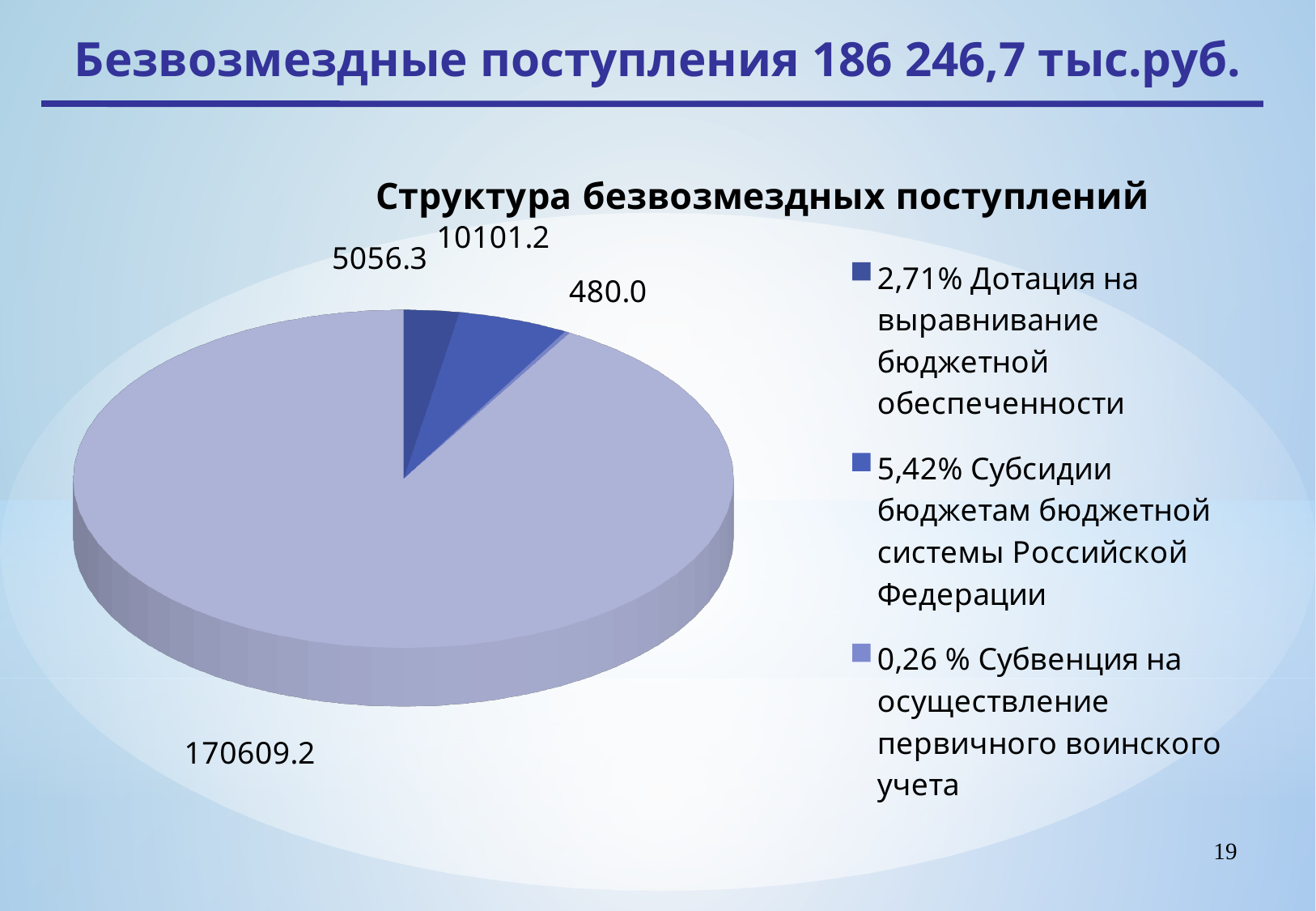
What is the chart's title? Структура безвозмездных поступлений What value is shown for Субвенция на осуществление первичного воинского учета? 480.0 How many slices does the pie chart have? 4 Which legend category has the smallest slice? Субвенция на осуществление первичного воинского учета What share of the pie does Субсидии бюджетам бюджетной системы Российской Федерации represent, according to the legend? 5,42% How many entries does the legend list? 3 What kind of chart is shown on the slide? pie chart What is the difference between the values for Субсидии бюджетам бюджетной системы Российской Федерации and Дотация на выравнивание бюджетной обеспеченности? 5044.9 What value is shown for Субсидии бюджетам бюджетной системы Российской Федерации? 10101.2 Which is larger: the value for Дотация на выравнивание бюджетной обеспеченности or for Субсидии бюджетам бюджетной системы Российской Федерации? Субсидии бюджетам бюджетной системы Российской Федерации What is the value of the largest slice of the pie? 170609.2 What value is shown for Дотация на выравнивание бюджетной обеспеченности? 5056.3